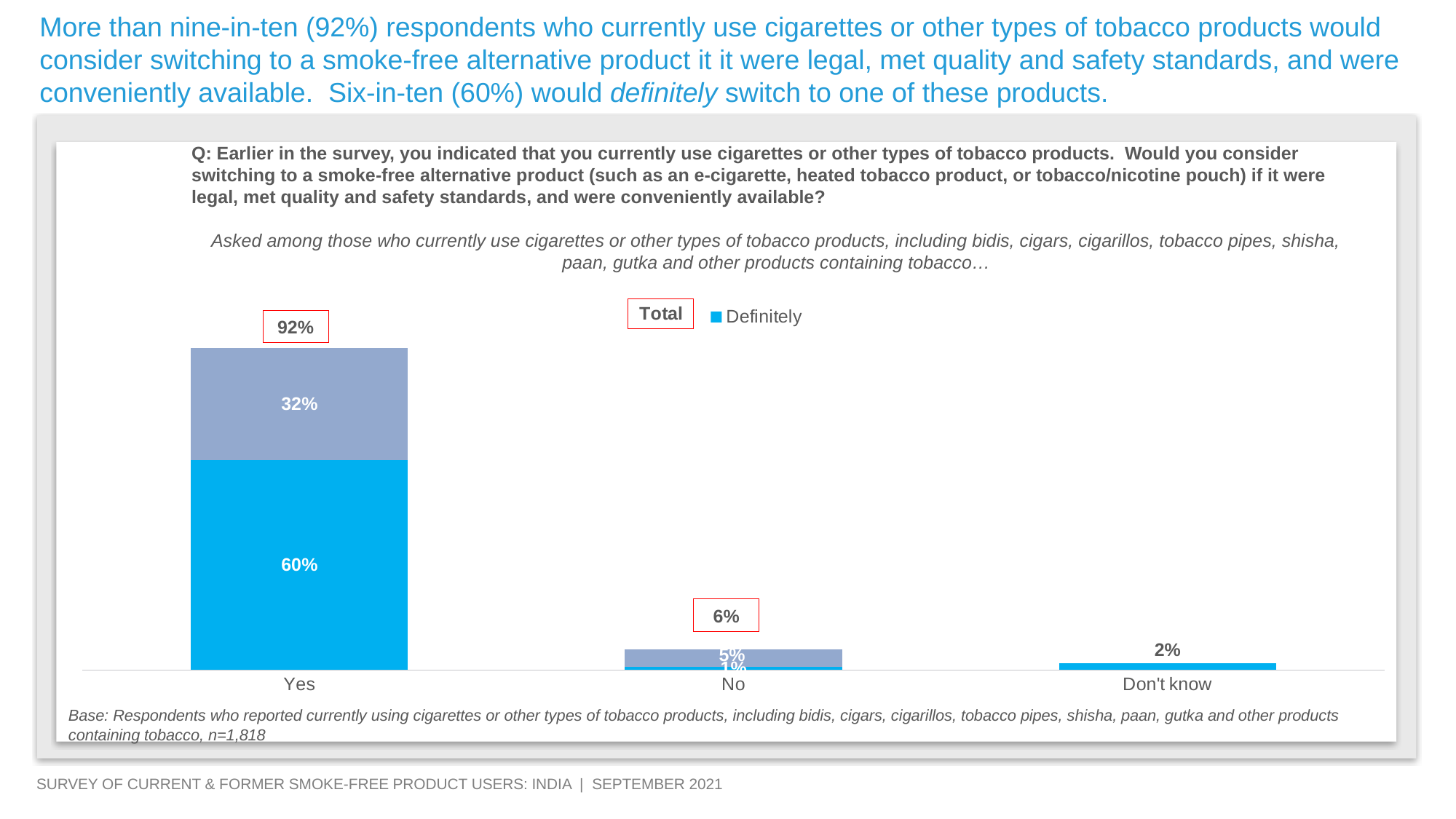
What is the sample size (n) stated in the base note below the chart? n=1,818 What is the total percentage shown above the 'Yes' bar? 92% Within the 'Yes' bar, which segment is larger: the 'Definitely' (blue) segment or the grey segment? Definitely (blue) How many response categories are shown along the x axis? 3 Which response category has the lowest percentage? Don't know What is the total percentage shown above the 'No' bar? 6% What is the difference between the total for 'Yes' and the total for 'No'? 86 percentage points What value is printed in the grey upper segment of the 'Yes' bar? 32% What percentage of respondents said they would 'Definitely' switch (the blue segment of the 'Yes' bar)? 60% What percentage is shown for the 'Don't know' category? 2% What type of chart is shown on the slide? Stacked bar chart Which response category has the highest total percentage? Yes